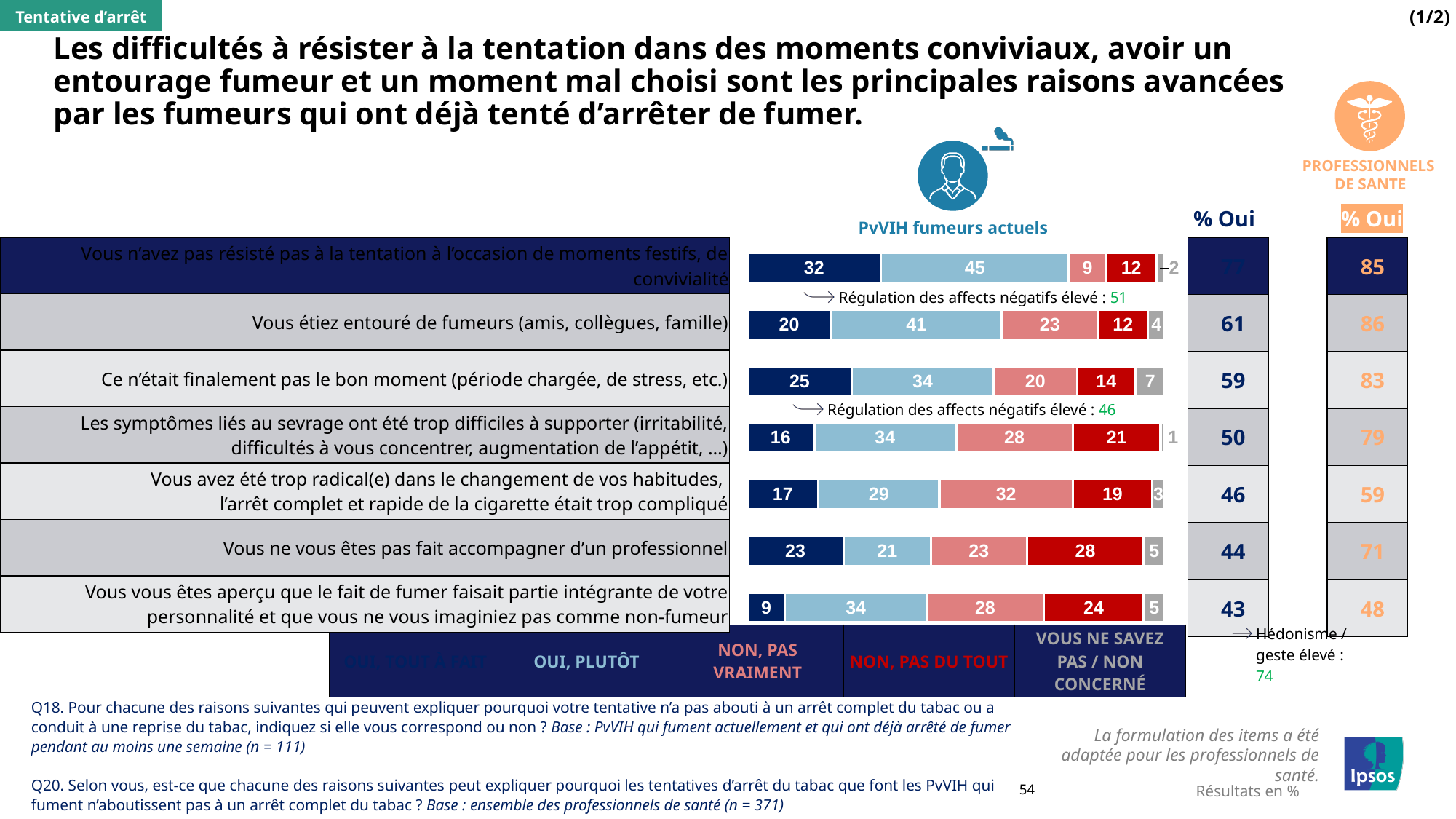
What is the total of the stacked bar for "Vous étiez entouré de fumeurs (amis, collègues, famille)"? 100 What is the "% Oui" value for "Professionnels de santé" for the category "Vous étiez entouré de fumeurs (amis, collègues, famille)"? 86 What is the value for "Oui, plutôt" for the category "Vous étiez entouré de fumeurs (amis, collègues, famille)"? 41 Which category has the highest value for "Oui, tout à fait"? Vous n'avez pas résisté pas à la tentation à l'occasion de moments festifs, de convivialité What is the value for "Non, pas du tout" for the category "Vous ne vous êtes pas fait accompagner d'un professionnel"? 28 What is the value for "Oui, tout à fait" for the category "Ce n'était finalement pas le bon moment (période chargée, de stress, etc.)"? 25 Which category has the larger "Non, pas vraiment" value: "Vous avez été trop radical(e) dans le changement de vos habitudes" or "Les symptômes liés au sevrage ont été trop difficiles à supporter"? Vous avez été trop radical(e) dans le changement de vos habitudes How many series does the legend list? 5 What is the difference between the "Oui, plutôt" value for "Vous n'avez pas résisté pas à la tentation à l'occasion de moments festifs, de convivialité" and the "Oui, plutôt" value for "Vous ne vous êtes pas fait accompagner d'un professionnel"? 24 How many categories (reasons) are shown in the chart? 7 What kind of chart is shown on the slide? Stacked bar chart Which category has the lowest value for "Oui, tout à fait"? Vous vous êtes aperçu que le fait de fumer faisait partie intégrante de votre personnalité et que vous ne vous imaginiez pas comme non-fumeur